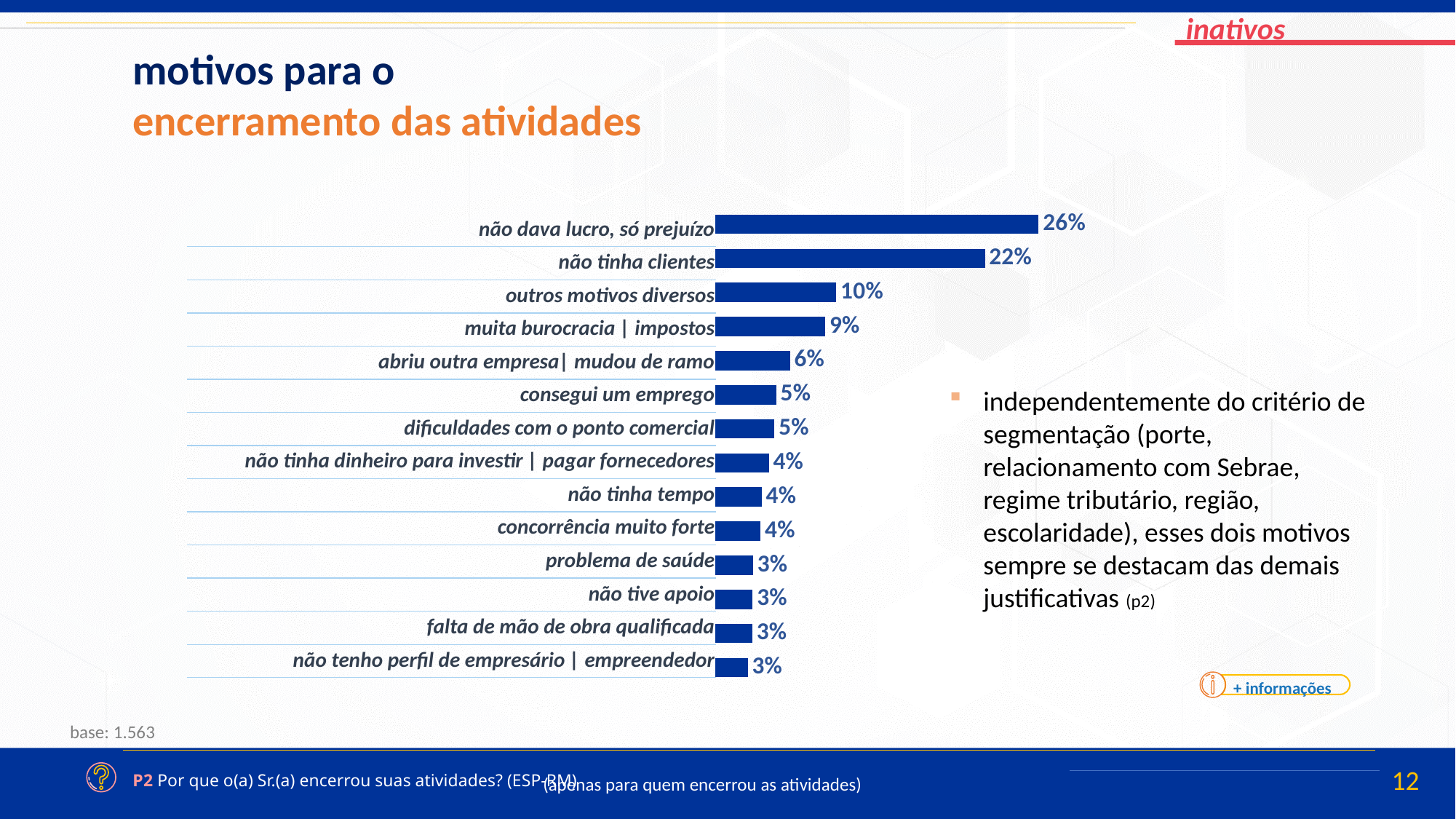
What is the value for "muita burocracia | impostos"? 9% Which category has the highest value? não dava lucro, só prejuízo What is the value for "problema de saúde"? 3% What is the base (sample size) shown below the chart? 1.563 Which is larger, "outros motivos diversos" or "muita burocracia | impostos"? outros motivos diversos What is the value for "abriu outra empresa| mudou de ramo"? 6% What is the difference between "outros motivos diversos" and "consegui um emprego"? 5% What is the difference between "não dava lucro, só prejuízo" and "não tinha clientes"? 4% How many categories are shown in the chart? 14 What is the value for "não tinha clientes"? 22% What is the value for "não dava lucro, só prejuízo"? 26% What kind of chart is shown on the slide? bar chart